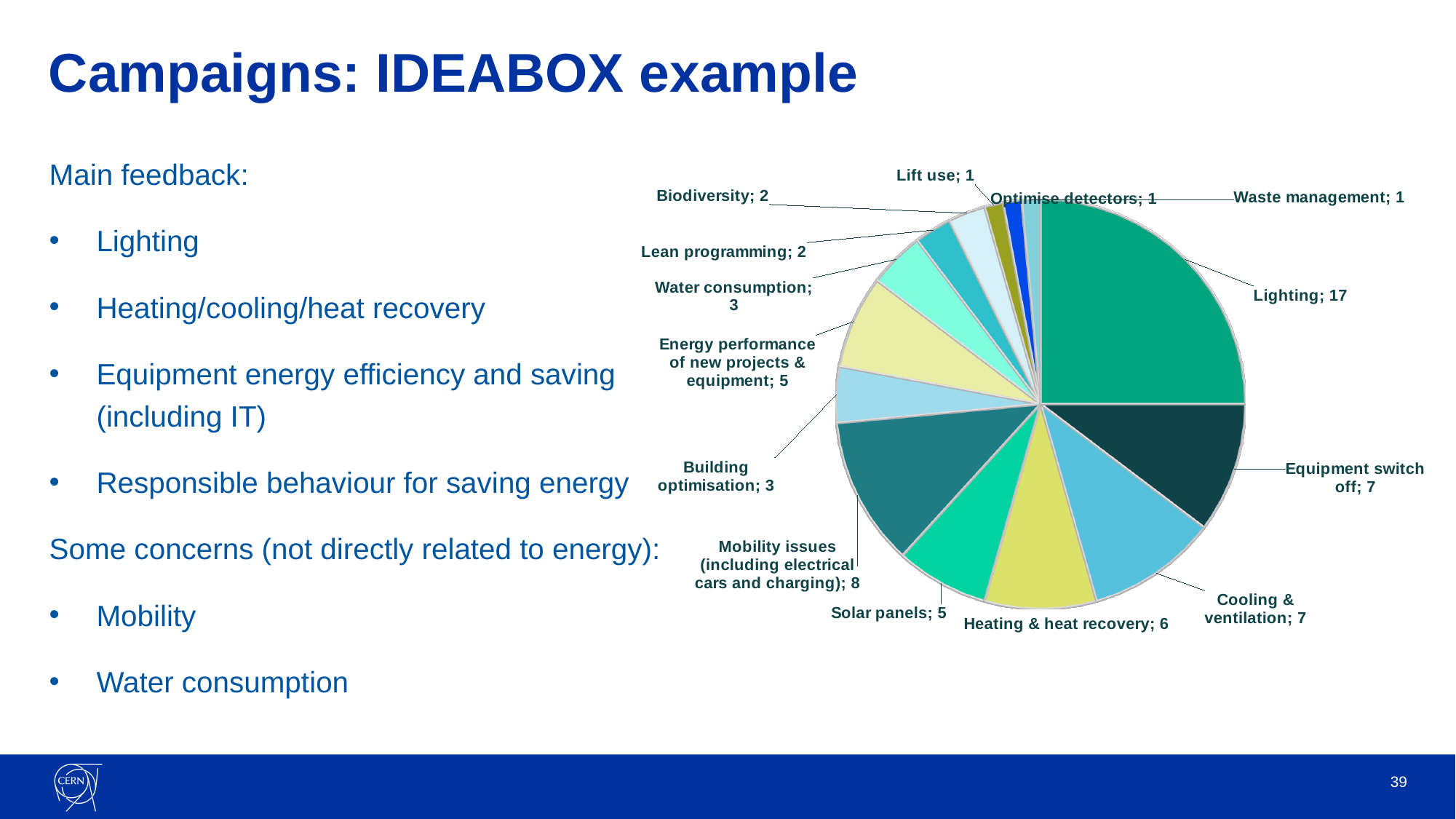
What is the value for Heating & heat recovery? 6 What is the total of all values in the pie chart? 68 What type of chart is shown on the slide? pie chart What is the difference between the values for Lighting and Mobility issues? 9 Which is larger, Solar panels or Heating & heat recovery? Heating & heat recovery Which category has the largest slice of the pie? Lighting How many categories are shown in the pie chart? 14 What share of the pie does Lighting represent? 25% What is the difference between Equipment switch off and Building optimisation? 4 How many ideas are in the Lighting category? 17 What is the value for Water consumption? 3 What is the value for Mobility issues (including electrical cars and charging)? 8